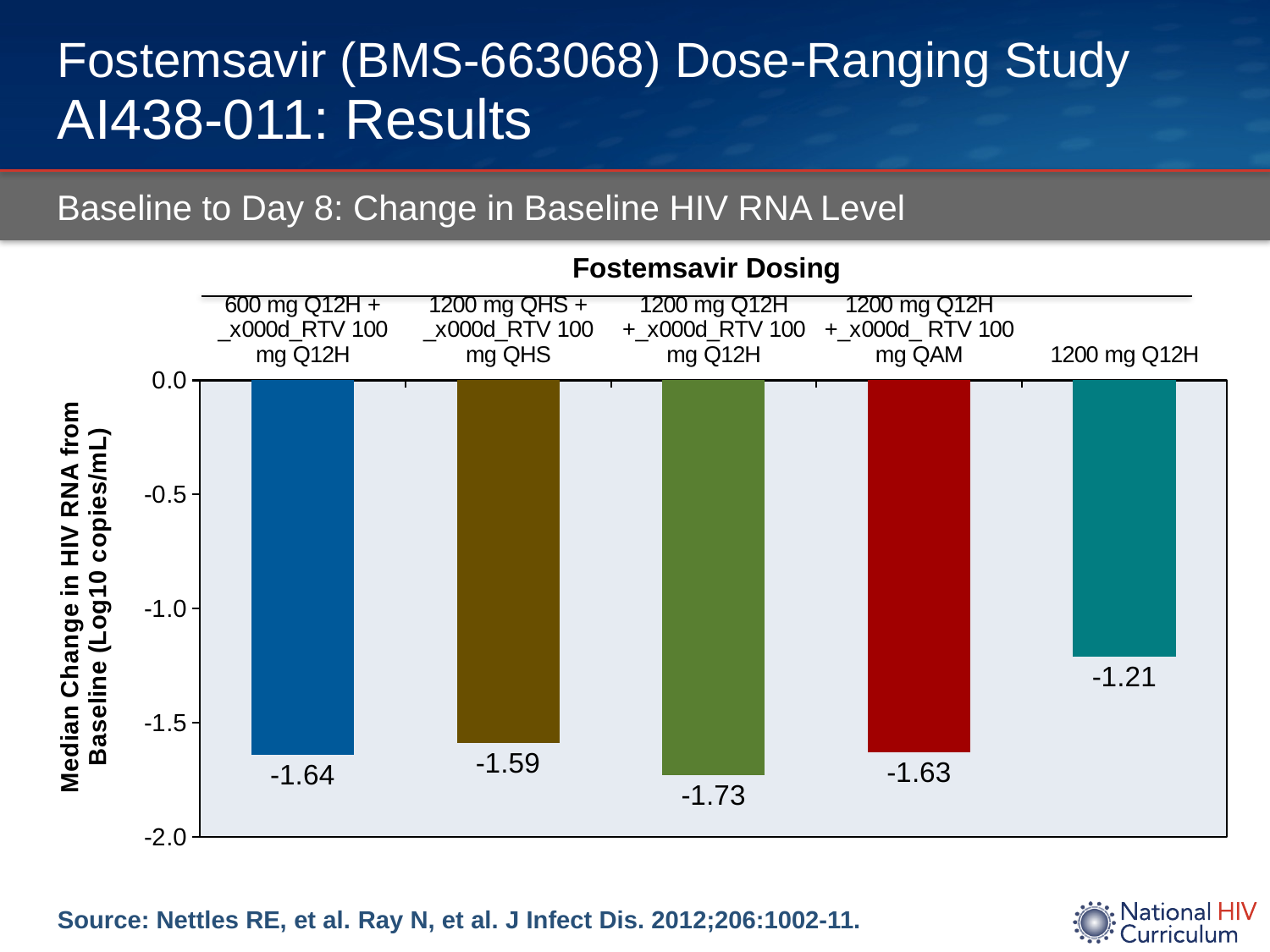
Which dosing group shows the smallest decrease (least negative median change) in HIV RNA? 1200 mg Q12H What is the difference between the median change for 1200 mg Q12H + RTV 100 mg Q12H (-1.73) and 1200 mg Q12H alone (-1.21)? 0.52 Is the value for the 1200 mg Q12H (no RTV) group greater or less than -1.0? less What is the median change in HIV RNA for the 1200 mg Q12H (no RTV) dosing group? -1.21 What is the median change in HIV RNA for the 600 mg Q12H + RTV 100 mg Q12H group? -1.64 How many dosing groups are plotted in the chart? 5 Which dosing group shows the largest decrease (most negative median change) in HIV RNA? 1200 mg Q12H + RTV 100 mg Q12H What is the median change in HIV RNA for the 1200 mg Q12H + RTV 100 mg QAM group? -1.63 What is the title printed above the chart's category labels? Fostemsavir Dosing What kind of chart is shown on the slide? bar chart What is the median change in HIV RNA for the 1200 mg QHS + RTV 100 mg QHS group? -1.59 Which group has a larger decrease in HIV RNA: 600 mg Q12H + RTV 100 mg Q12H or 1200 mg Q12H alone? 600 mg Q12H + RTV 100 mg Q12H